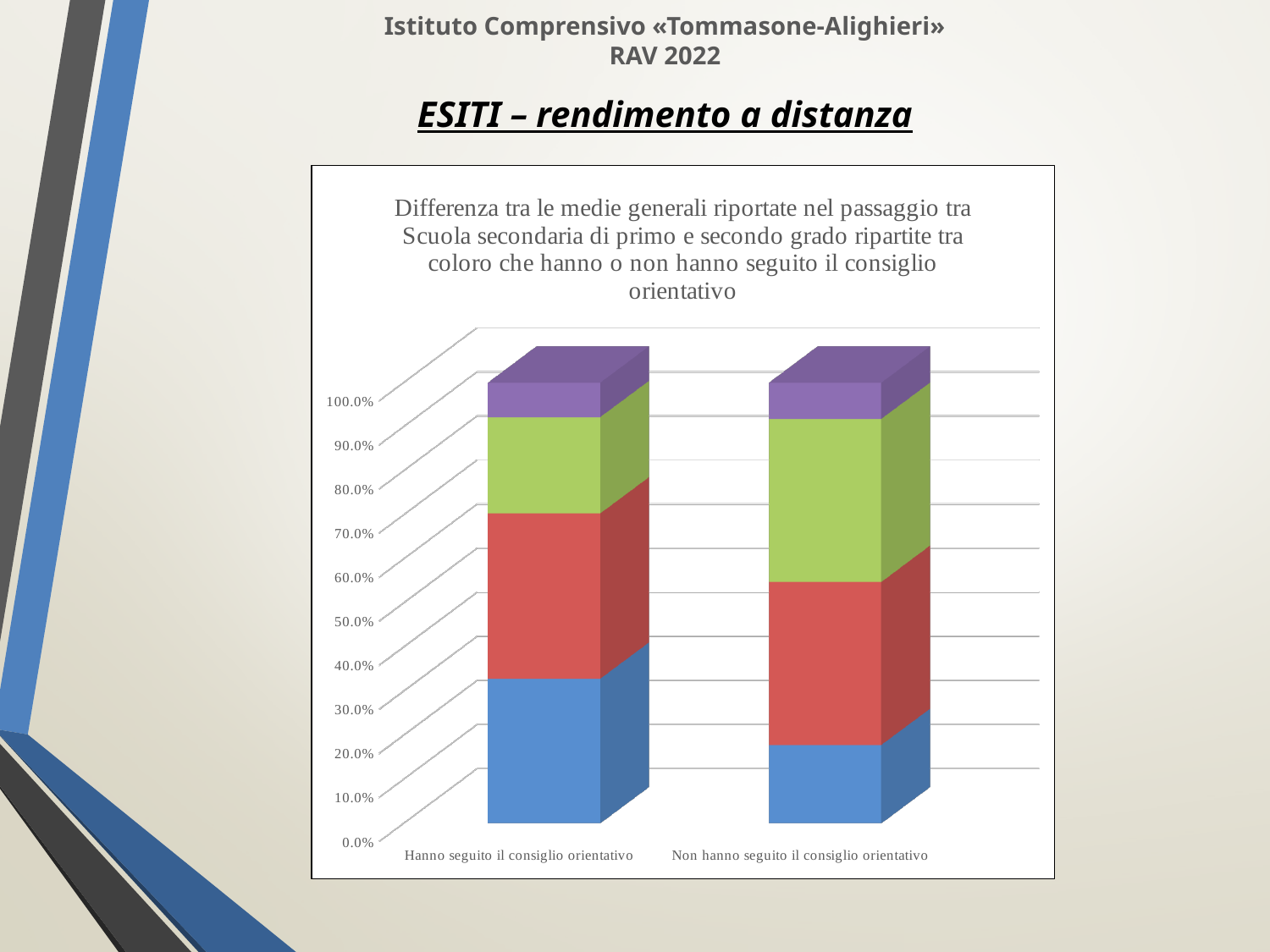
Which category has the larger green segment, 'Hanno seguito il consiglio orientativo' or 'Non hanno seguito il consiglio orientativo'? Non hanno seguito il consiglio orientativo What colour is the bottom segment of each stacked bar in the chart? blue Is the green segment for 'Non hanno seguito il consiglio orientativo' greater or less than 30%? greater Is the blue (bottom) segment for 'Non hanno seguito il consiglio orientativo' greater or less than 30%? less How many categories are shown on the x axis of the chart? 2 What kind of chart is shown on the slide? stacked bar chart Is the blue (bottom) segment for 'Hanno seguito il consiglio orientativo' greater or less than 30%? greater How many coloured segments make up each stacked bar in the chart? 4 Which category has the larger blue (bottom) segment, 'Hanno seguito il consiglio orientativo' or 'Non hanno seguito il consiglio orientativo'? Hanno seguito il consiglio orientativo What is the highest value labelled on the y axis of the chart? 100.0%